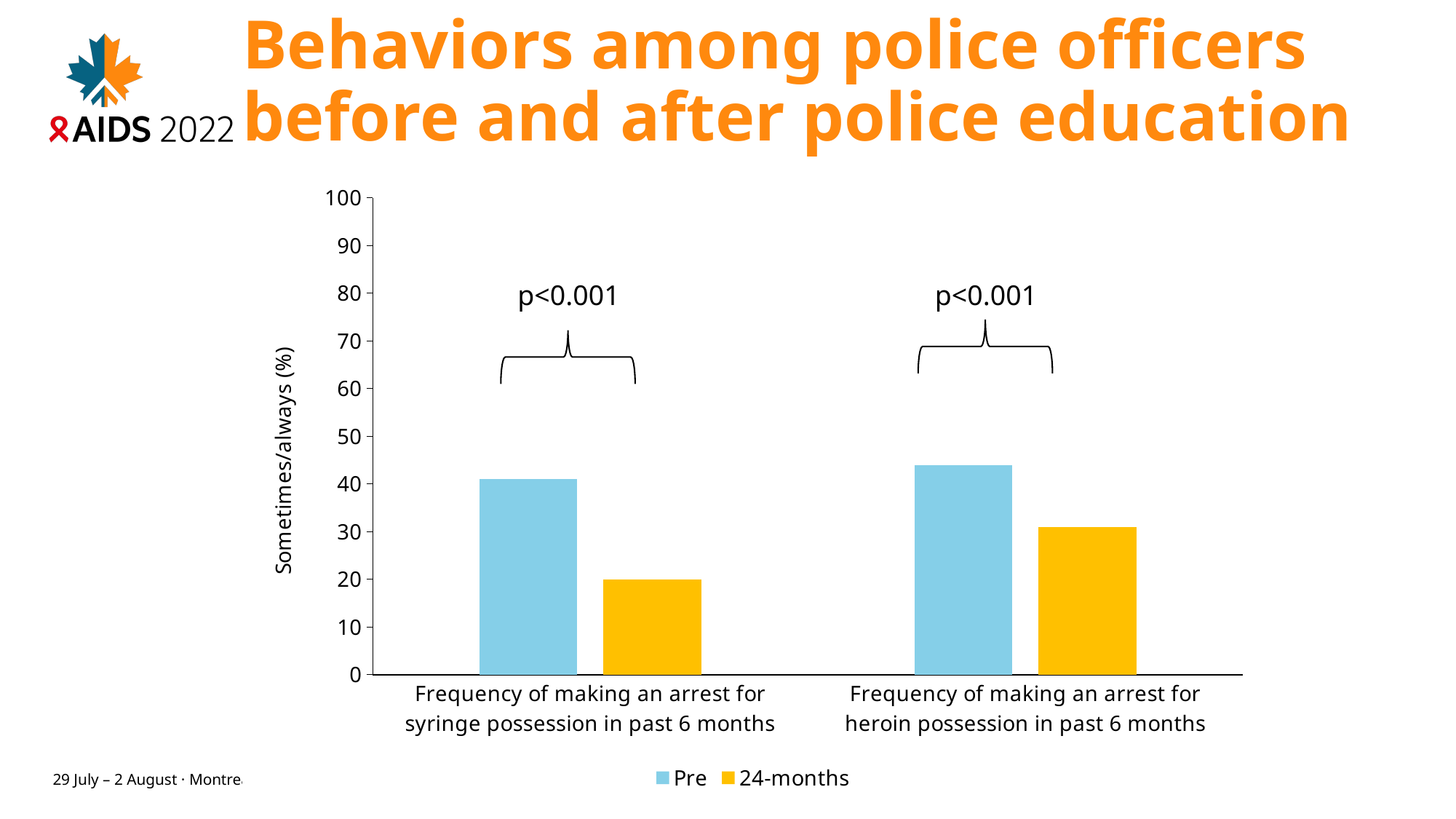
What kind of chart is shown on the slide? bar chart For frequency of making an arrest for syringe possession in past 6 months, which is larger: the Pre value or the 24-months value? Pre For frequency of making an arrest for heroin possession in past 6 months, which is larger: the Pre value or the 24-months value? Pre Is the 24-months value for frequency of making an arrest for syringe possession in past 6 months greater or less than 30? less What are the two series named in the legend? Pre and 24-months Which bar is the lowest on the chart? 24-months for frequency of making an arrest for syringe possession in past 6 months How many categories are shown on the x axis? 2 Is the Pre value for frequency of making an arrest for syringe possession in past 6 months greater or less than 30? greater What is the label of the y axis? Sometimes/always (%) Is the 24-months value for frequency of making an arrest for heroin possession in past 6 months greater or less than 20? greater How many series does the legend list? 2